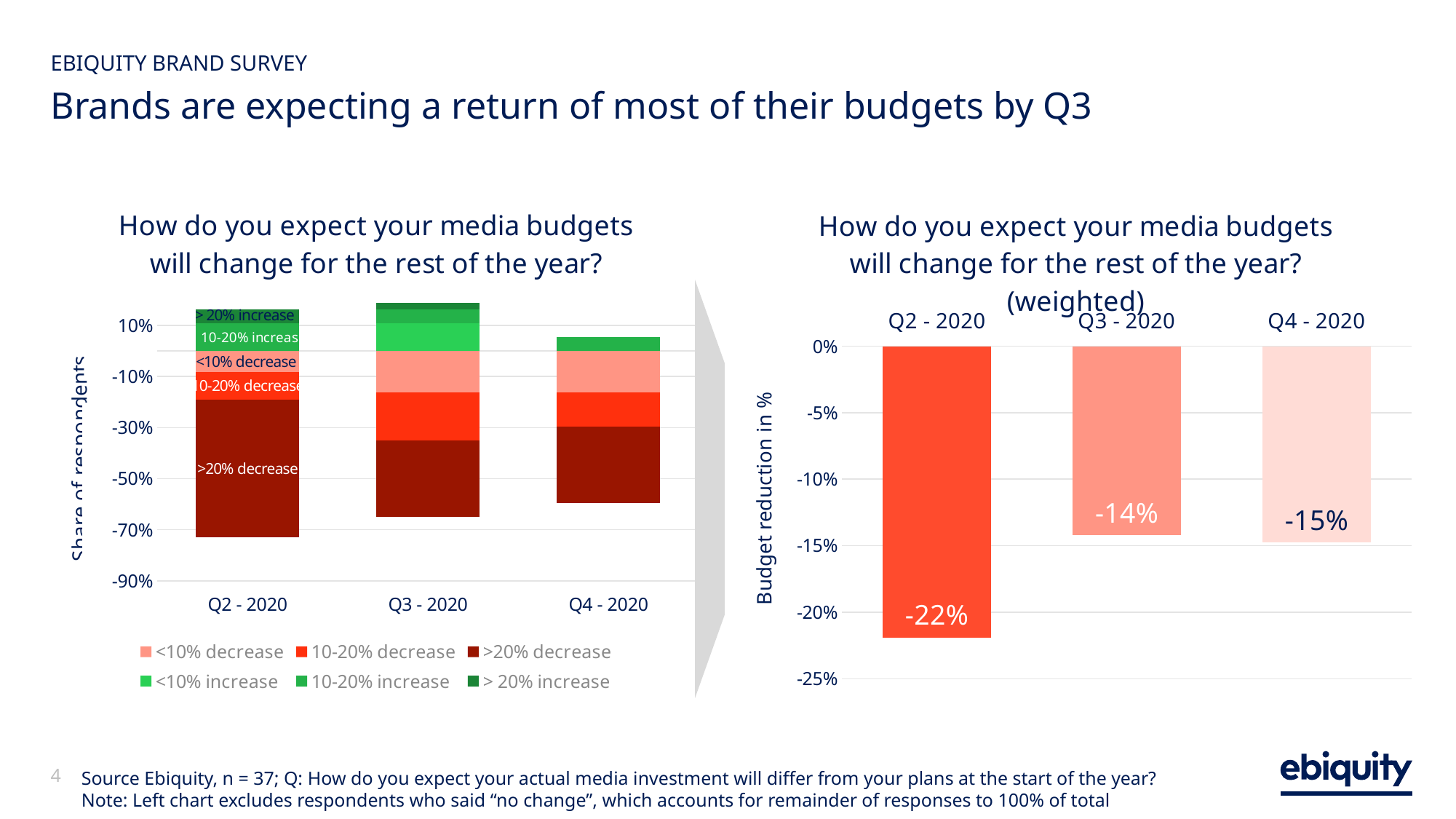
What is the y-axis label of the right chart? Budget reduction in % In the right chart (weighted), what is the expected budget reduction for Q2 - 2020? -22% How many quarters are shown on the x axis of the left chart? 3 What kind of chart is the left chart? Stacked bar chart In the right chart (weighted), which quarter has the larger budget reduction, Q3 - 2020 or Q4 - 2020? Q4 - 2020 In the right chart (weighted), which quarter shows the smallest budget reduction? Q3 - 2020 In the left chart, does the Q2 - 2020 bar extend below -70% on the y axis? Yes In the right chart (weighted), which quarter shows the largest budget reduction? Q2 - 2020 How many series does the legend of the left chart list? 6 In the right chart (weighted), what is the expected budget reduction for Q4 - 2020? -15% In the right chart (weighted), what is the expected budget reduction for Q3 - 2020? -14% In the right chart (weighted), by how many percentage points does the Q2 - 2020 reduction exceed the Q3 - 2020 reduction? 8 percentage points